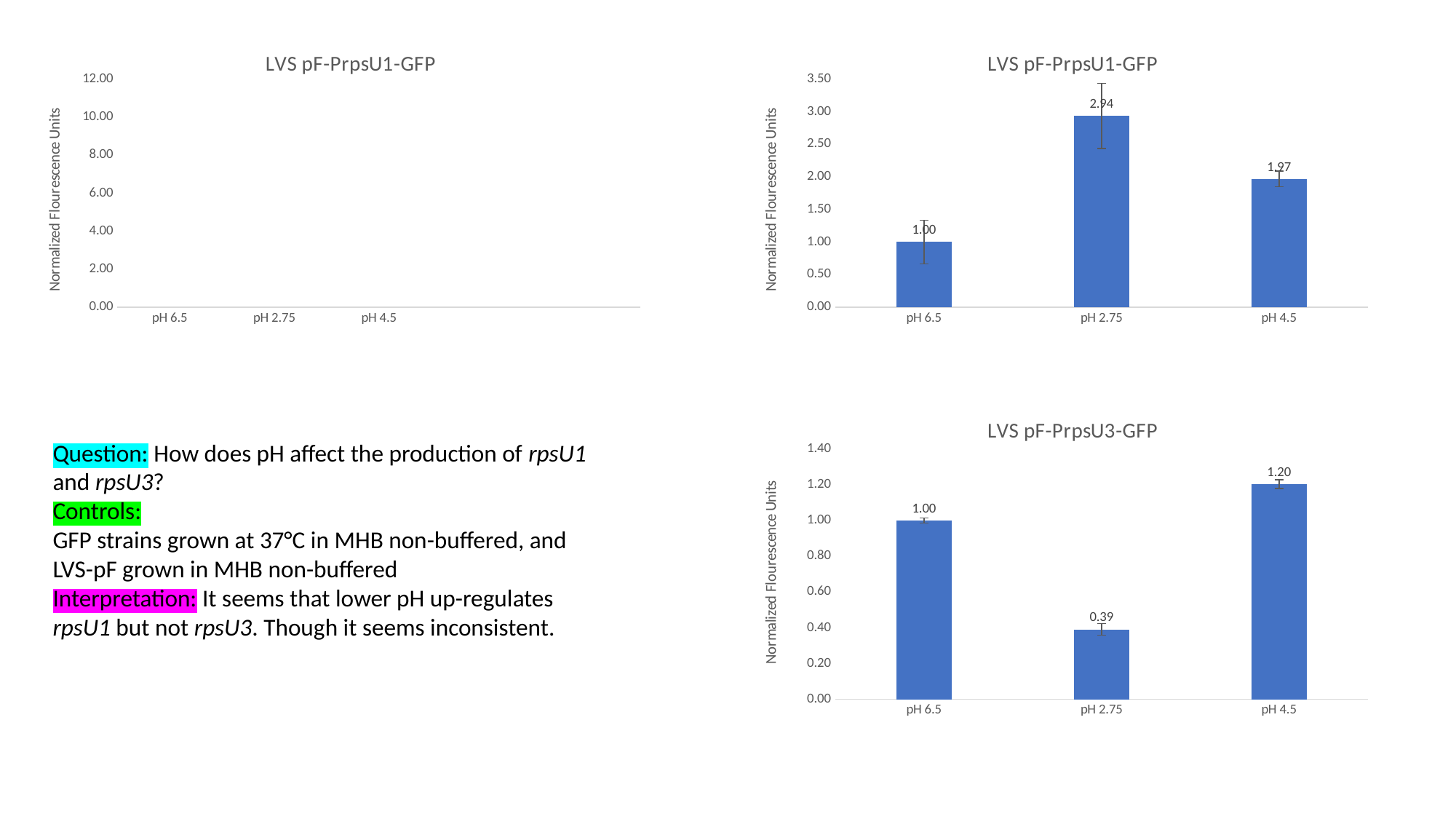
How many pH categories are shown on the x axis of the bottom-right chart titled LVS pF-PrpsU3-GFP? 3 In the top-right chart titled LVS pF-PrpsU1-GFP, what is the value for pH 4.5? 1.97 In the top-right chart titled LVS pF-PrpsU1-GFP, which pH condition has the highest value? pH 2.75 In the bottom-right chart titled LVS pF-PrpsU3-GFP, what is the value for pH 4.5? 1.20 In the bottom-right chart titled LVS pF-PrpsU3-GFP, which is larger, the value for pH 6.5 or the value for pH 4.5? pH 4.5 In the bottom-right chart titled LVS pF-PrpsU3-GFP, what is the value for pH 2.75? 0.39 What kind of chart is the top-right chart titled LVS pF-PrpsU1-GFP? Bar chart In the bottom-right chart titled LVS pF-PrpsU3-GFP, what is the difference between the values for pH 4.5 and pH 2.75? 0.81 In the top-right chart titled LVS pF-PrpsU1-GFP, what is the difference between the values for pH 2.75 and pH 4.5? 0.97 In the top-right chart titled LVS pF-PrpsU1-GFP, which pH condition has the lowest value? pH 6.5 In the top-right chart titled LVS pF-PrpsU1-GFP, what is the value for pH 2.75? 2.94 In the bottom-right chart titled LVS pF-PrpsU3-GFP, which pH condition has the lowest value? pH 2.75